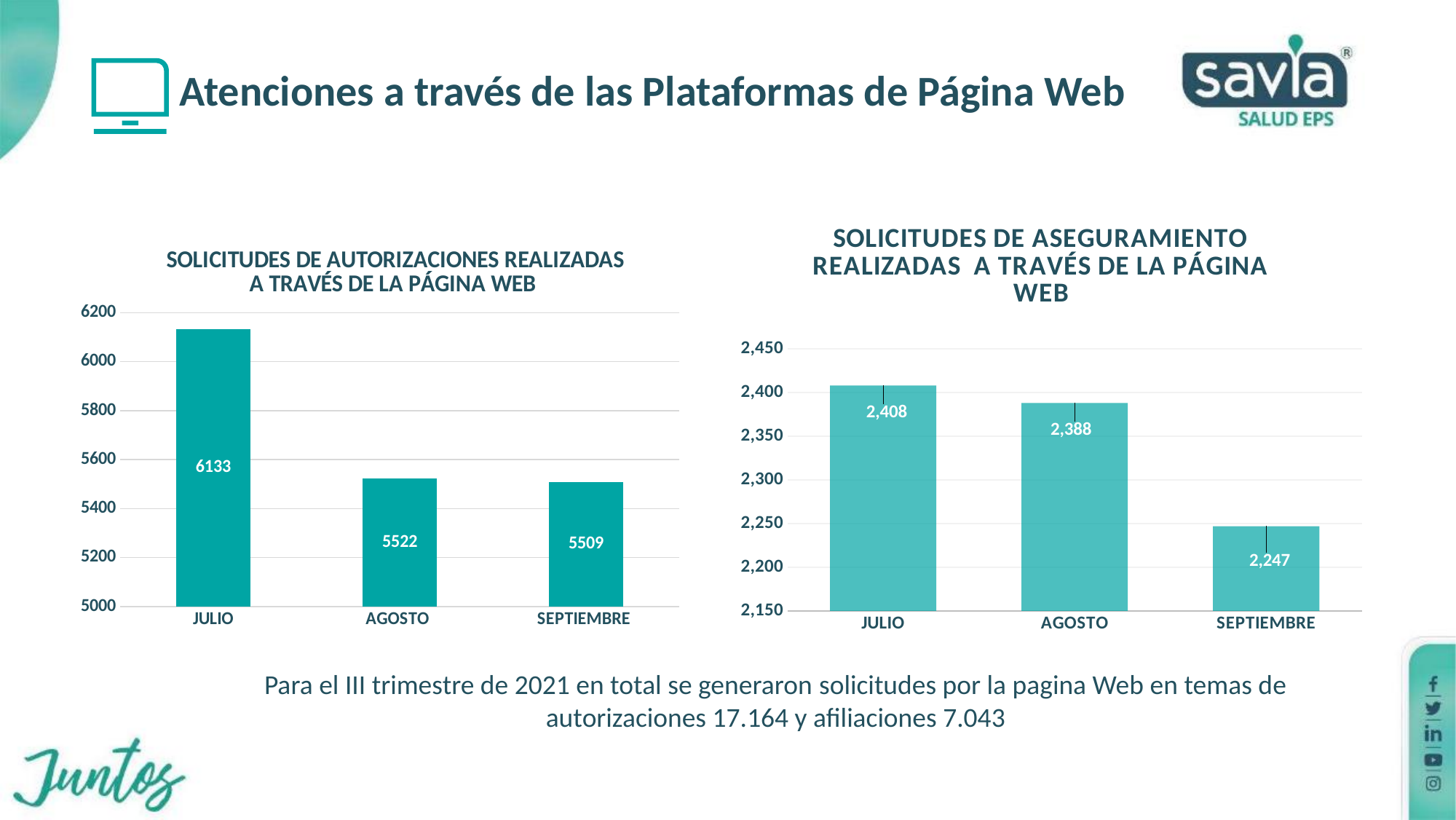
How many months are shown in the left chart (Solicitudes de Autorizaciones)? 3 In the right chart (Solicitudes de Aseguramiento), do the values rise or fall from JULIO to SEPTIEMBRE? Fall In the right chart (Solicitudes de Aseguramiento), what is the value for AGOSTO? 2,388 In the right chart (Solicitudes de Aseguramiento), which is larger, JULIO or AGOSTO? JULIO In the left chart (Solicitudes de Autorizaciones), which month has the highest value? JULIO In the left chart (Solicitudes de Autorizaciones), what is the difference between JULIO and AGOSTO? 611 In the right chart (Solicitudes de Aseguramiento), what is the value for SEPTIEMBRE? 2,247 In the left chart (Solicitudes de Autorizaciones), what is the value for SEPTIEMBRE? 5509 In the left chart (Solicitudes de Autorizaciones), what is the value for JULIO? 6133 In the right chart (Solicitudes de Aseguramiento), which month has the lowest value? SEPTIEMBRE What type of chart is the right chart (Solicitudes de Aseguramiento)? Bar chart In the right chart (Solicitudes de Aseguramiento), what is the difference between JULIO and SEPTIEMBRE? 161